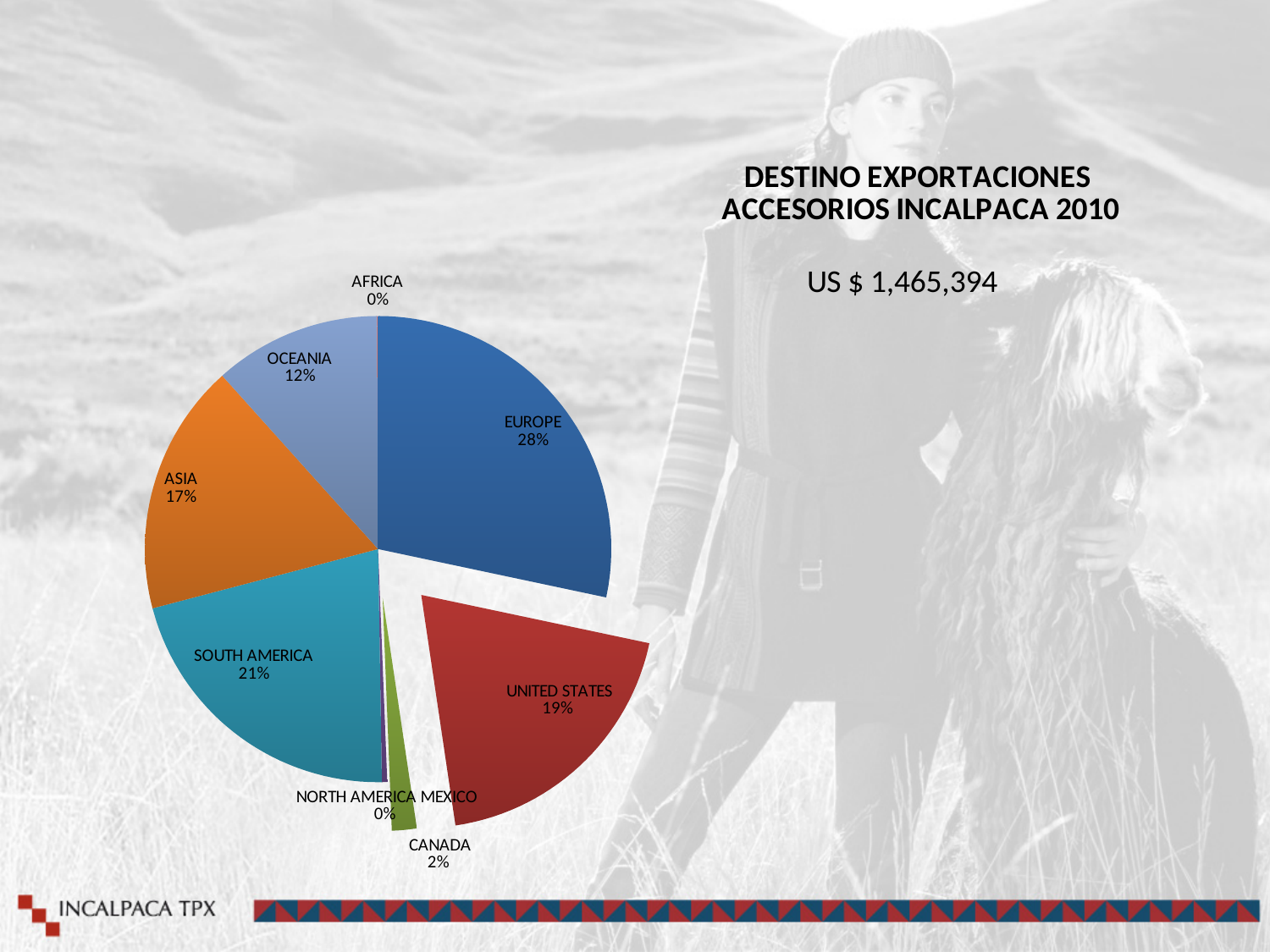
How many destination categories are shown in the pie chart? 8 What total export value is shown next to the chart? US $ 1,465,394 What is the difference in percentage points between Europe's share and South America's share? 7% What share of exports went to Canada? 2% What share of exports went to Oceania? 12% What is the title of the chart? DESTINO EXPORTACIONES ACCESORIOS INCALPACA 2010 What is the difference in percentage points between Asia's share and Oceania's share? 5% Which destination has the largest share of the pie? Europe Which has the larger share, Asia or United States? United States What type of chart is shown on the slide? Pie chart What share of exports went to Europe? 28% What share of exports went to South America? 21%